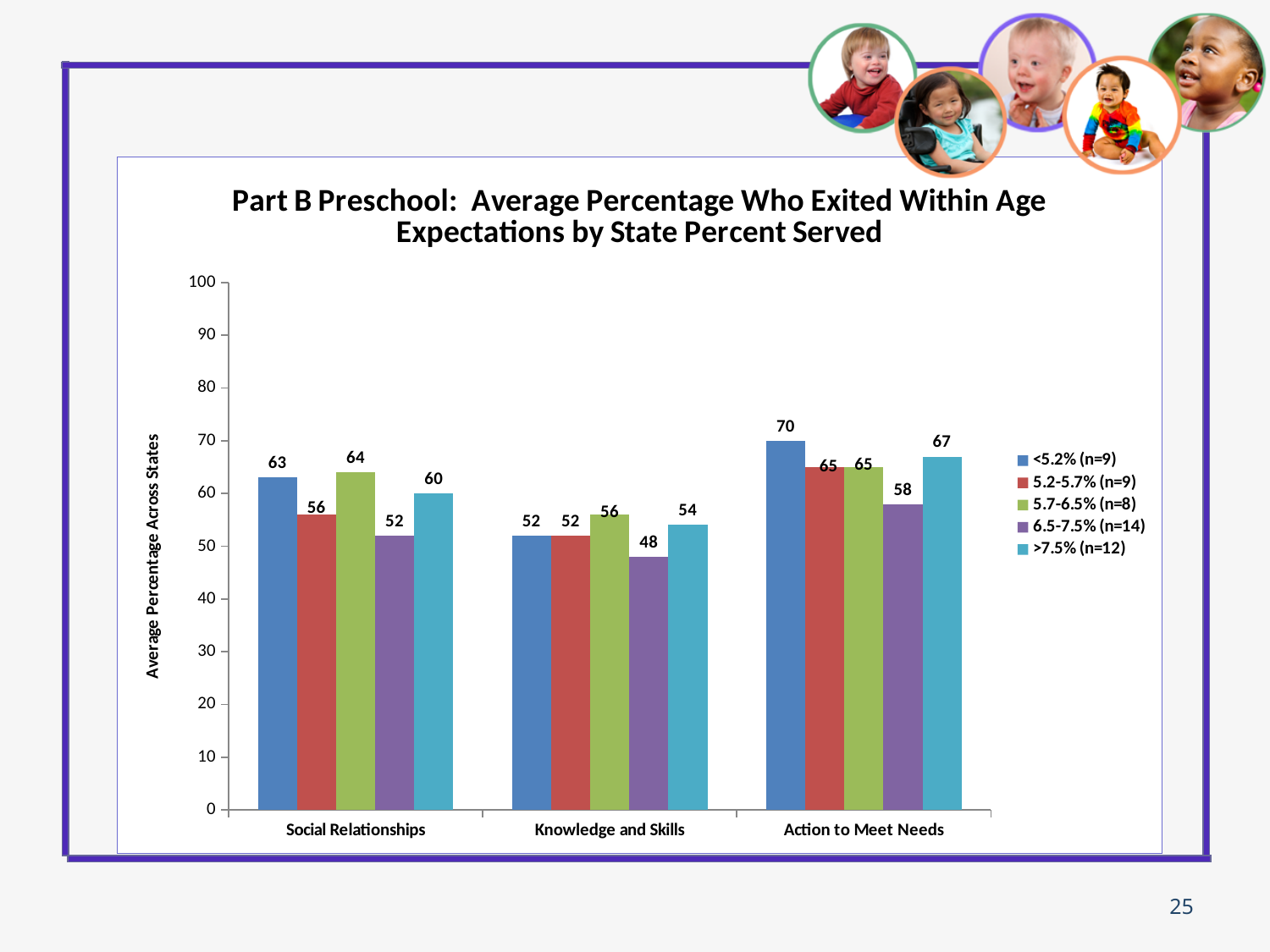
What is the label of the y axis? Average Percentage Across States Which is larger in the Social Relationships category: the 5.7-6.5% (n=8) value or the >7.5% (n=12) value? 5.7-6.5% (n=8) Which series has the lowest value in the Knowledge and Skills category? 6.5-7.5% (n=14) What kind of chart is shown on the slide? Bar chart What is the value for the <5.2% (n=9) series in the Social Relationships category? 63 How many series does the legend list? 5 What is the value for the 6.5-7.5% (n=14) series in the Knowledge and Skills category? 48 Is the value for the 5.2-5.7% (n=9) series in the Action to Meet Needs category greater or less than 60? greater What is the value for the >7.5% (n=12) series in the Action to Meet Needs category? 67 What is the difference between the <5.2% (n=9) value and the 6.5-7.5% (n=14) value in the Social Relationships category? 11 Which series has the highest value in the Action to Meet Needs category? <5.2% (n=9) How many categories are shown on the x axis? 3